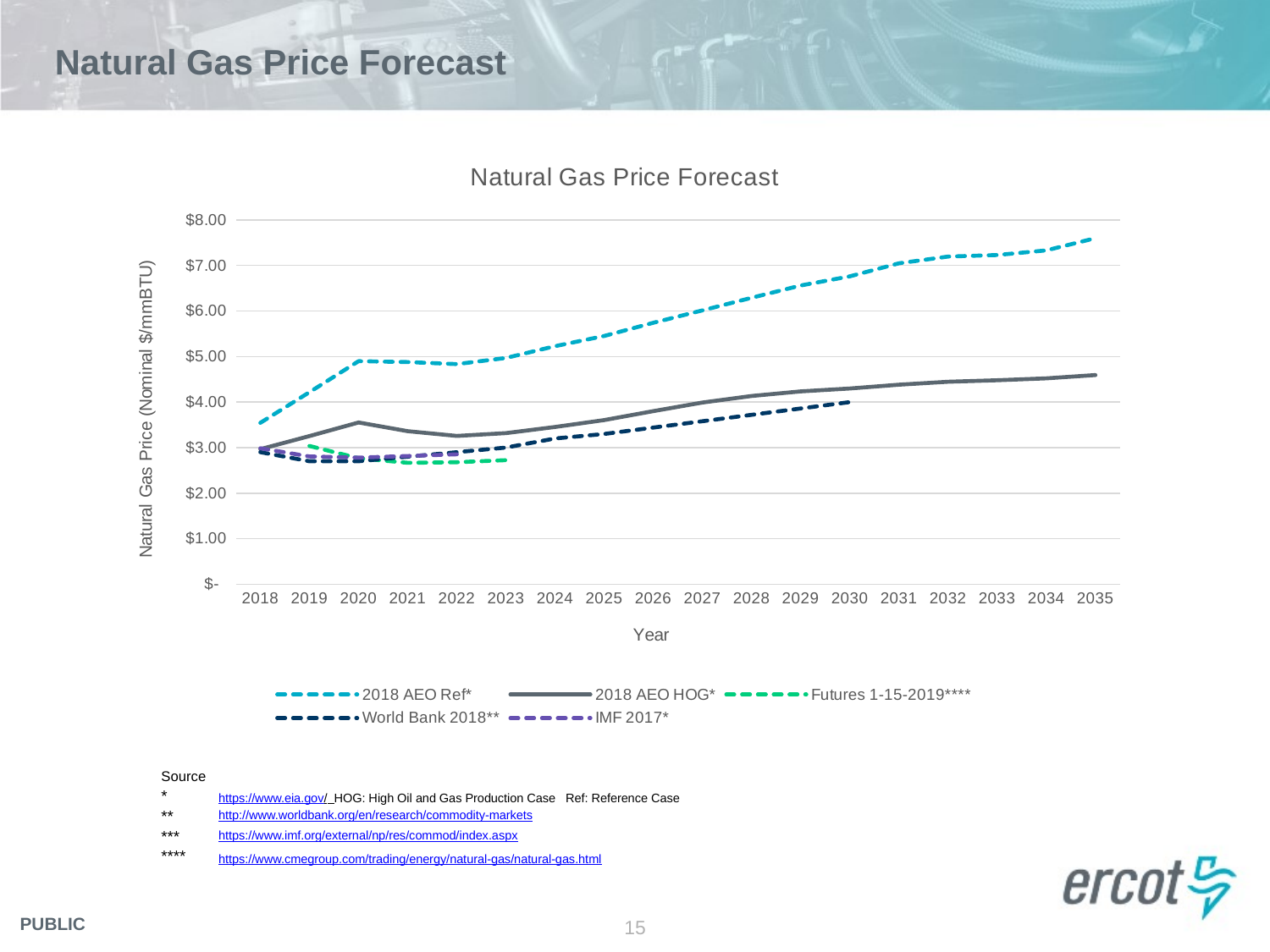
How many series does the legend list? 5 How many years are shown along the x axis? 18 Is the value for 2018 AEO Ref* in 2025 greater or less than $5.00? greater In 2035, which is larger: 2018 AEO Ref* or 2018 AEO HOG*? 2018 AEO Ref* Is the value for Futures 1-15-2019**** in 2023 greater or less than $3.00? less Which series has the highest value in 2035? 2018 AEO Ref* What is the label of the y axis? Natural Gas Price (Nominal $/mmBTU) Is the value for 2018 AEO HOG* in 2035 greater or less than $5.00? less What is the title of the chart? Natural Gas Price Forecast Does the 2018 AEO Ref* series rise or fall from 2018 to 2035? rise What kind of chart is shown on the slide? Line chart